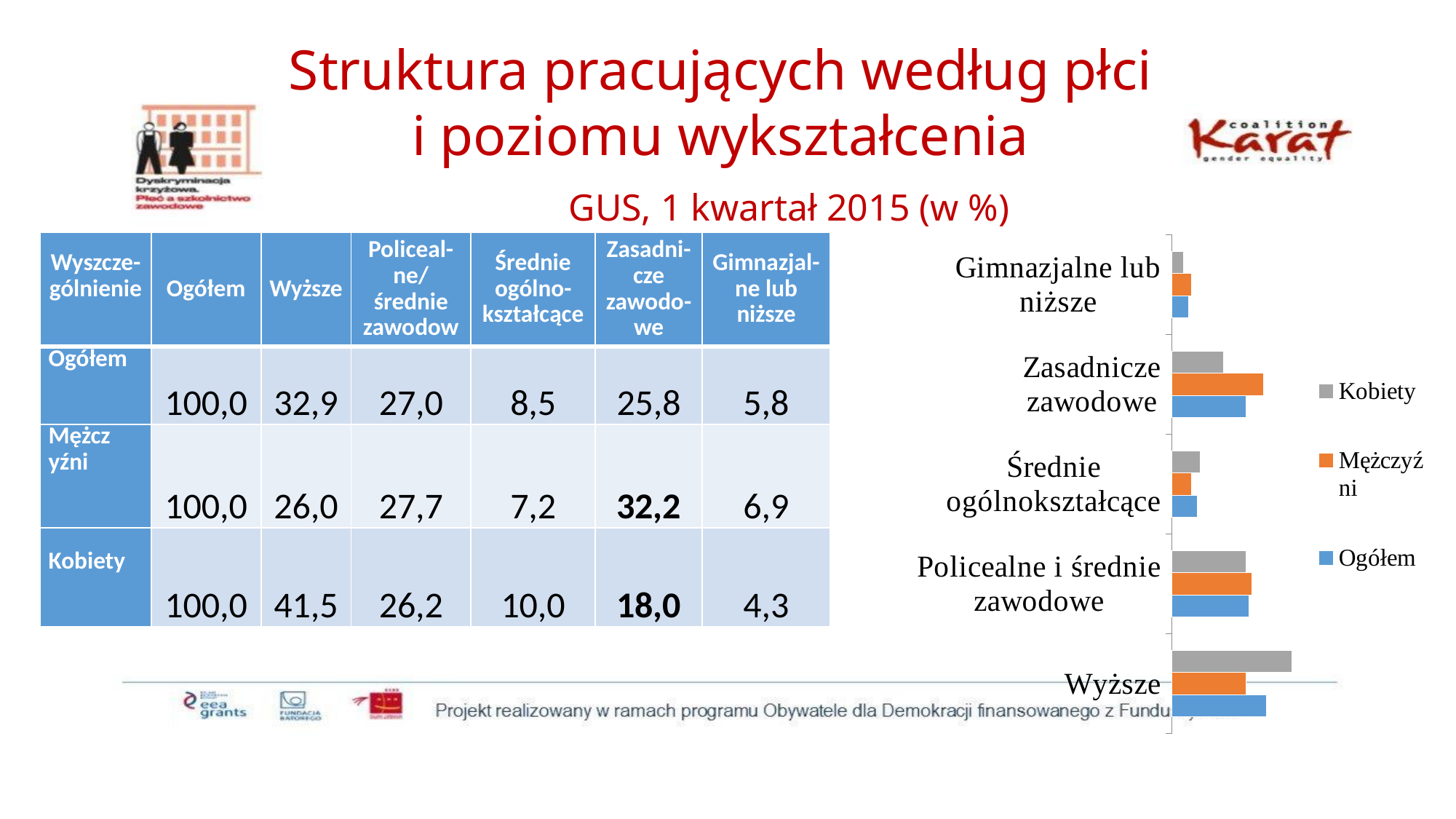
In the bar chart, for Gimnazjalne lub niższe, which is larger: the Kobiety bar or the Mężczyźni bar? Mężczyźni In the bar chart, which colour represents the Kobiety series? grey In the bar chart, for Zasadnicze zawodowe, which is larger: the Kobiety bar or the Mężczyźni bar? Mężczyźni In the bar chart, which education category has the longest Mężczyźni bar? Zasadnicze zawodowe How many series does the legend of the bar chart list? 3 How many education categories are plotted on the bar chart? 5 In the bar chart, which education category has the longest Kobiety bar? Wyższe In the bar chart, for Wyższe, which is larger: the Kobiety bar or the Mężczyźni bar? Kobiety What kind of chart is shown on the right of the slide? bar chart In the bar chart, which education category has the longest Ogółem bar? Wyższe In the bar chart, which series is shown in orange? Mężczyźni In the bar chart, which education category has the shortest Kobiety bar? Gimnazjalne lub niższe